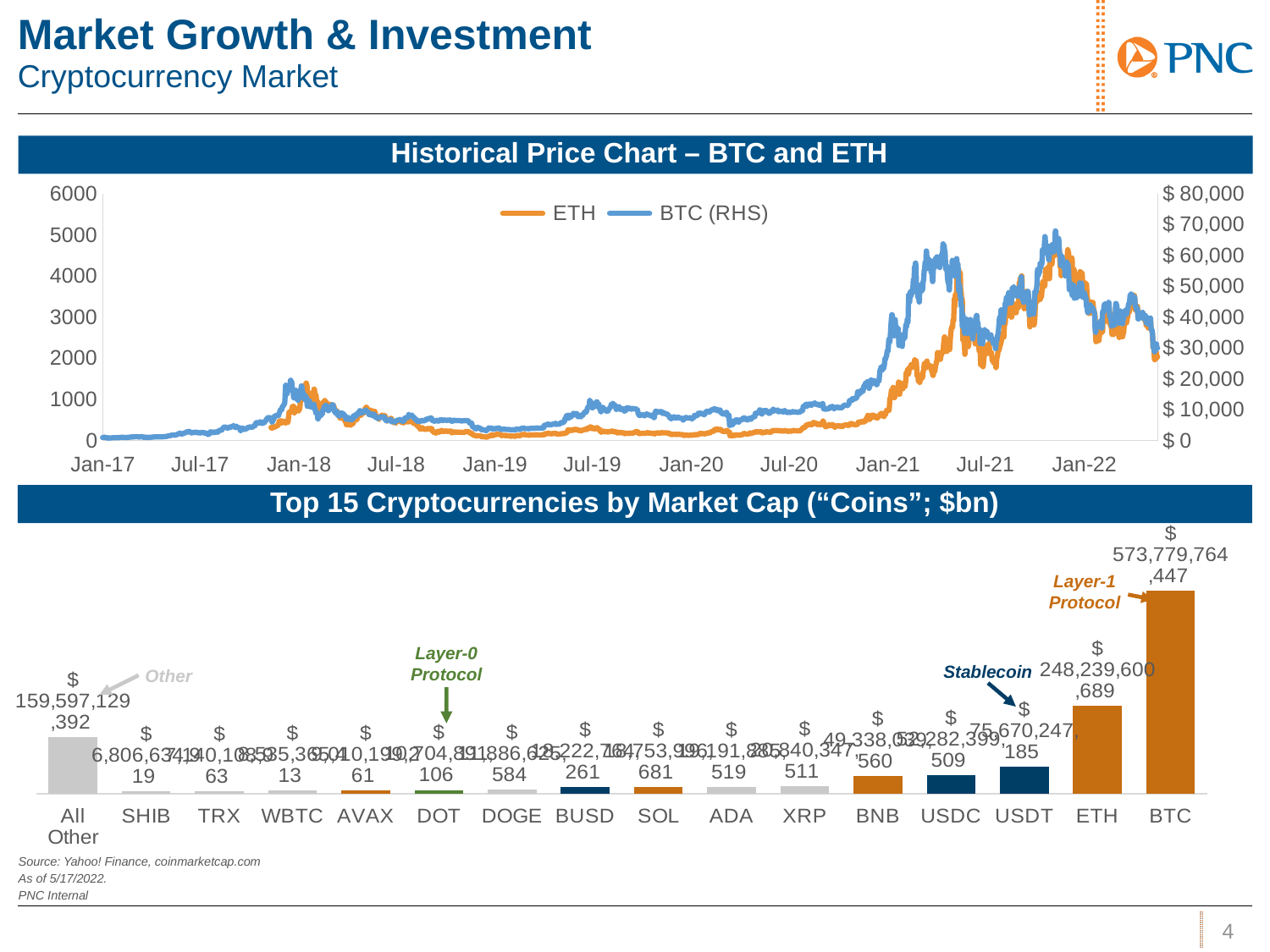
What kind of chart is 'Top 15 Cryptocurrencies by Market Cap'? bar chart In the 'Historical Price Chart – BTC and ETH', which series is plotted on the right-hand axis? BTC (RHS) In 'Top 15 Cryptocurrencies by Market Cap', what is the market cap shown for BTC? $573,779,764,447 How many series does the legend of the 'Historical Price Chart – BTC and ETH' list? 2 In the 'Historical Price Chart – BTC and ETH', is the peak BTC value in late 2021 greater or less than $60,000? greater In 'Top 15 Cryptocurrencies by Market Cap', what is the market cap shown for ETH? $248,239,600,689 In 'Top 15 Cryptocurrencies by Market Cap', which bar is annotated as 'Stablecoin'? USDT In 'Top 15 Cryptocurrencies by Market Cap', which category has the highest market cap? BTC What kind of chart is the 'Historical Price Chart – BTC and ETH'? line chart In 'Top 15 Cryptocurrencies by Market Cap', which is larger, the market cap of ETH or of USDT? ETH In the 'Historical Price Chart – BTC and ETH', do the ETH values overall rise or fall from Jan-17 to Jan-22? rise In the 'Historical Price Chart – BTC and ETH', is the ETH value at Jan-17 greater or less than 1000? less